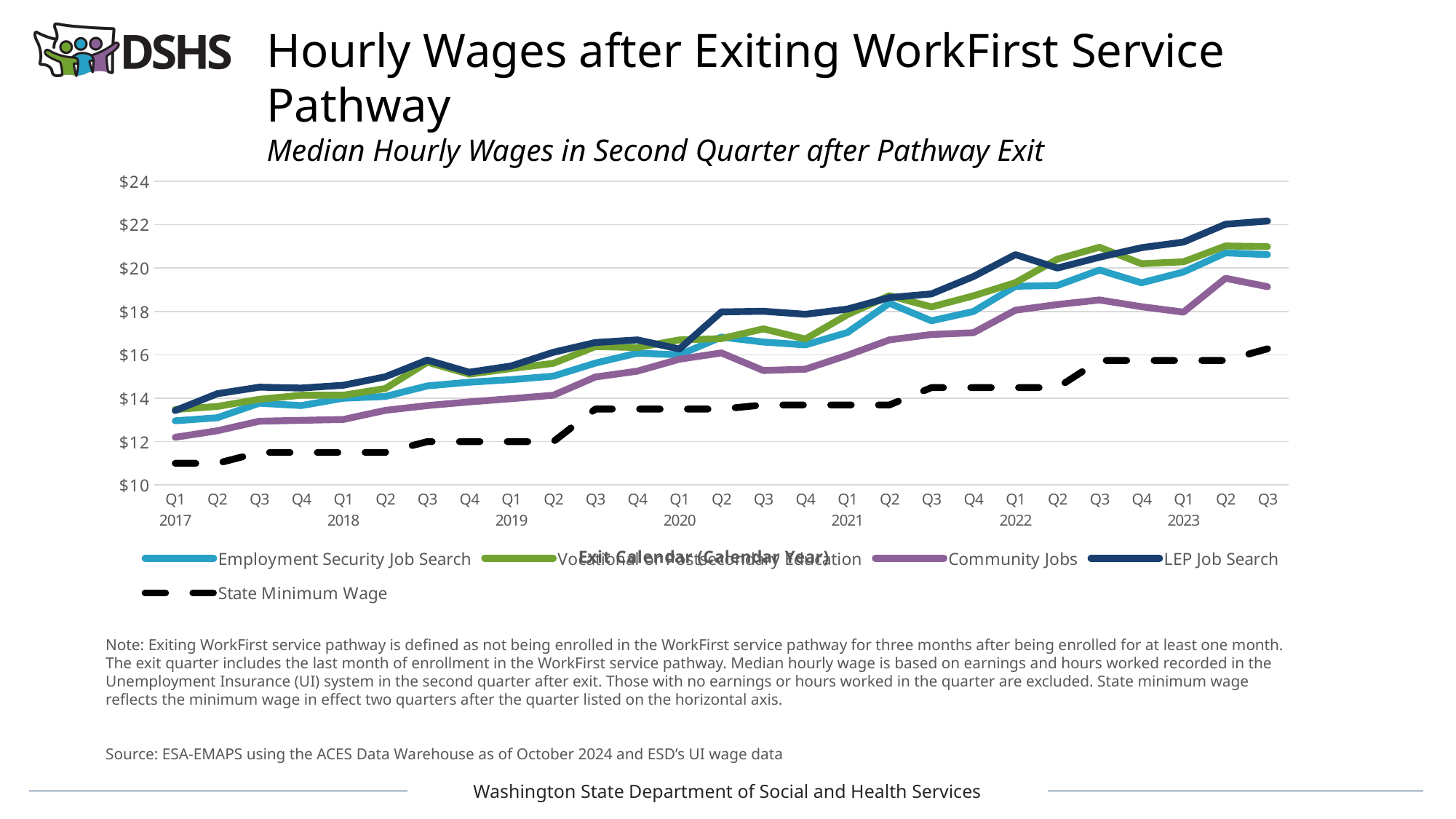
Among the four pathway series, which has the lowest value at Q3 2023? Community Jobs Is the value for LEP Job Search at Q3 2023 greater or less than $20? greater Which series is lowest across the whole chart? State Minimum Wage How many series does the legend list? 5 Which series has the highest value at Q3 2023? LEP Job Search Which series is drawn with a dashed line? State Minimum Wage How many quarters are plotted along the x axis? 27 At Q3 2023, which is higher: LEP Job Search or Community Jobs? LEP Job Search What kind of chart is shown on the slide? Line chart Is the value for Community Jobs at Q3 2023 greater or less than $20? less Is the value for State Minimum Wage at Q1 2017 greater or less than $12? less Does the State Minimum Wage line rise or fall from Q1 2017 to Q3 2023? Rise